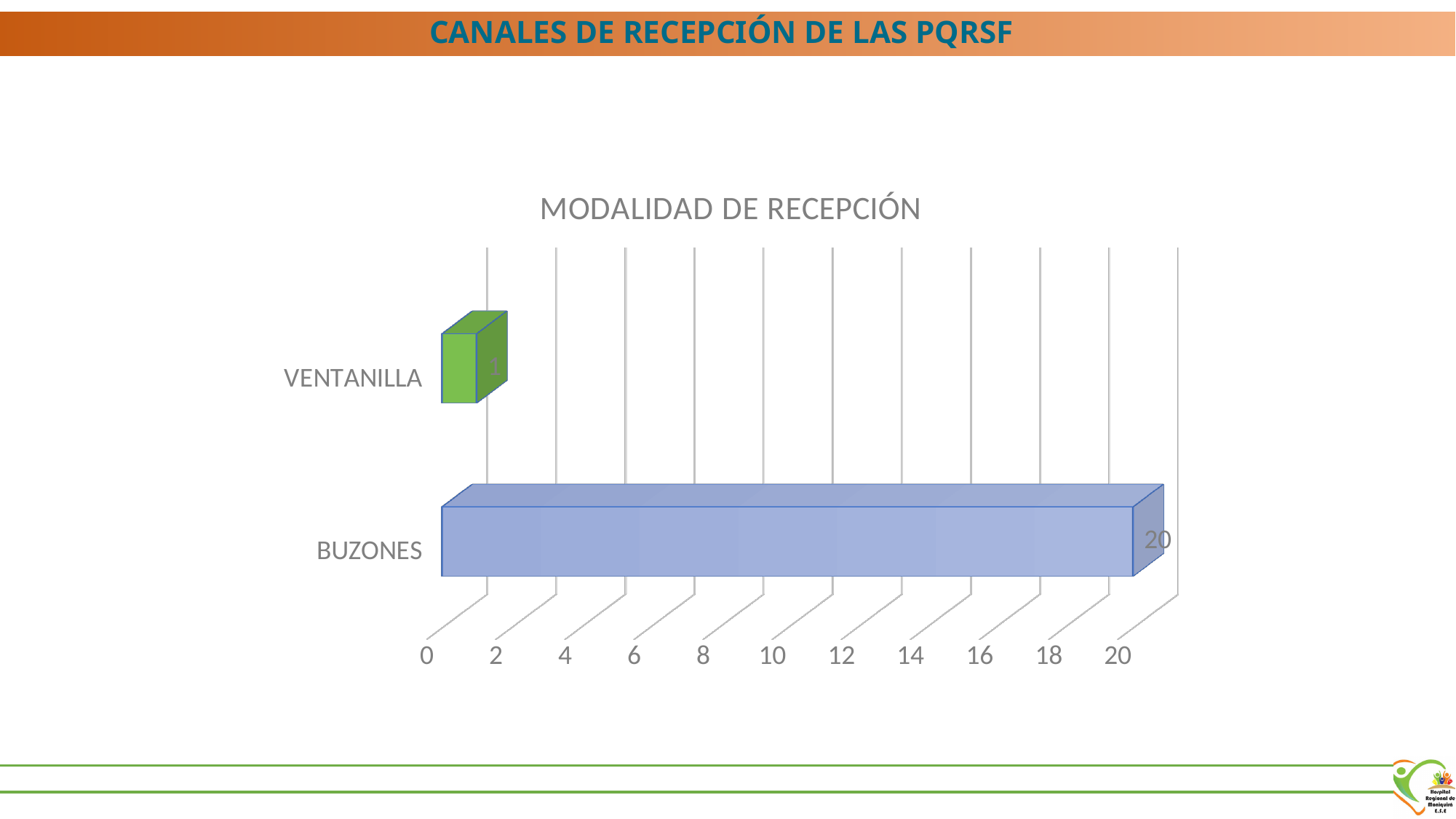
What kind of chart is shown on the slide? Bar chart Which category has the lowest value? VENTANILLA What is the difference between the values for BUZONES and VENTANILLA? 19 Which category has the highest value? BUZONES What is the value for VENTANILLA? 1 Which is larger, the value for BUZONES or the value for VENTANILLA? BUZONES How many categories are shown in the chart? 2 What is the value for BUZONES? 20 What colour is the bar for VENTANILLA? Green What is the title of the chart? MODALIDAD DE RECEPCIÓN Is the value for BUZONES greater or less than 10? greater Is the value for VENTANILLA greater or less than 2? less